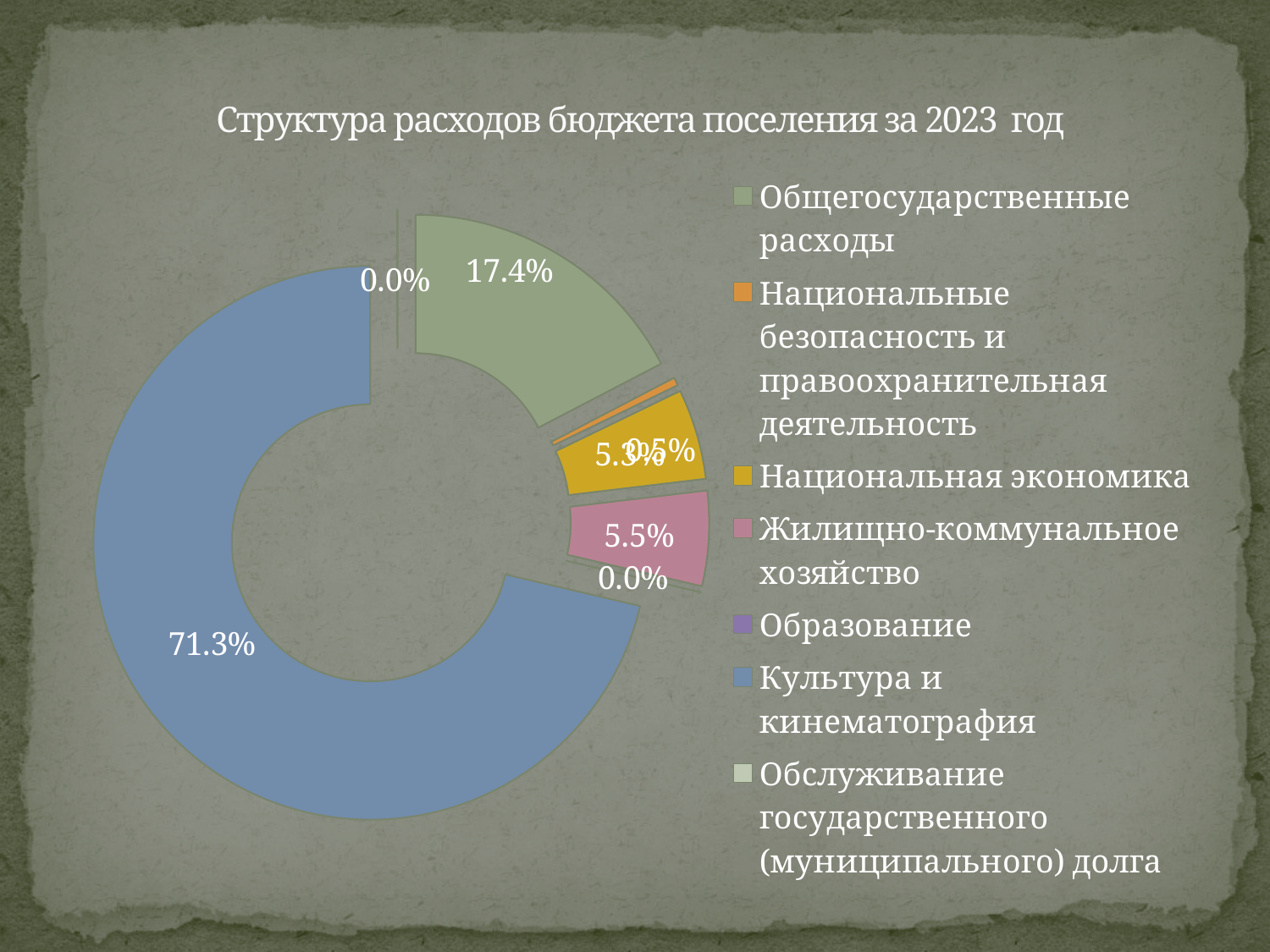
Which is larger: the share for Общегосударственные расходы or the share for Жилищно-коммунальное хозяйство? Общегосударственные расходы Which category has the largest share of the budget expenditures? Культура и кинематография How many categories are listed in the chart legend? 7 What share of expenditures goes to Культура и кинематография? 71.3% By how many percentage points does the share for Культура и кинематография exceed the share for Общегосударственные расходы? 53.9 percentage points What share of expenditures goes to Национальная экономика? 5.3% By how many percentage points does the share for Общегосударственные расходы exceed the share for Жилищно-коммунальное хозяйство? 11.9 percentage points What kind of chart is shown on the slide? doughnut (pie) chart What share of expenditures goes to Жилищно-коммунальное хозяйство? 5.5% What share of expenditures goes to Общегосударственные расходы? 17.4% What share of expenditures goes to Образование? 0.0% What is the title of the chart? Структура расходов бюджета поселения за 2023 год